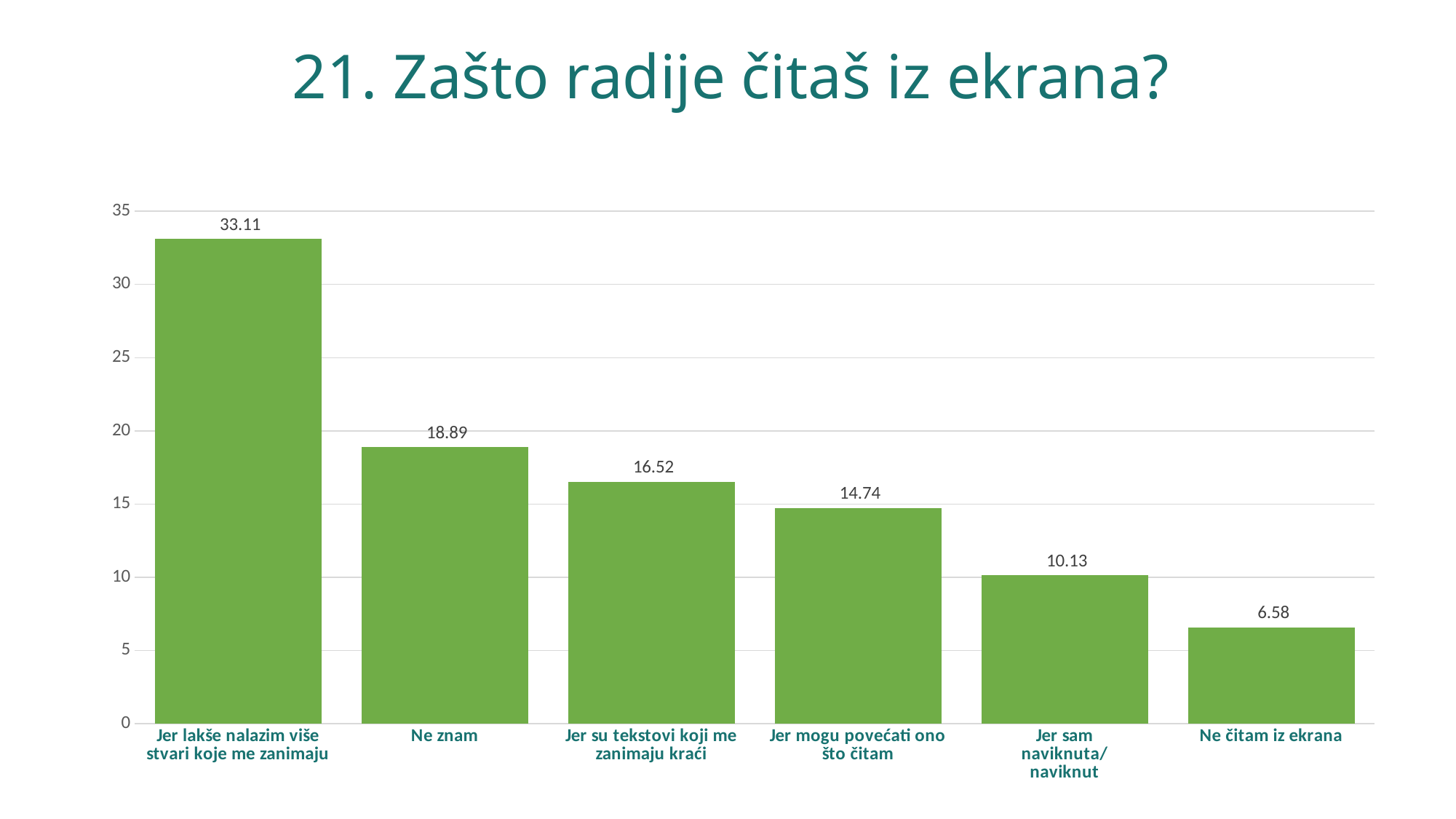
Is the value for "Jer sam naviknuta/naviknut" greater or less than 15? less How many categories are shown in the chart? 6 What is the value for "Ne znam"? 18.89 What is the value for "Jer mogu povećati ono što čitam"? 14.74 Which category has the lowest value? Ne čitam iz ekrana What is the difference between the values for "Ne znam" and "Jer su tekstovi koji me zanimaju kraći"? 2.37 Which is larger, the value for "Jer sam naviknuta/naviknut" or the value for "Jer mogu povećati ono što čitam"? Jer mogu povećati ono što čitam What is the value for "Ne čitam iz ekrana"? 6.58 Which category has the highest value? Jer lakše nalazim više stvari koje me zanimaju What kind of chart is shown on the slide? bar chart What is the title of the chart? 21. Zašto radije čitaš iz ekrana? What is the difference between the values for "Jer lakše nalazim više stvari koje me zanimaju" and "Ne čitam iz ekrana"? 26.53